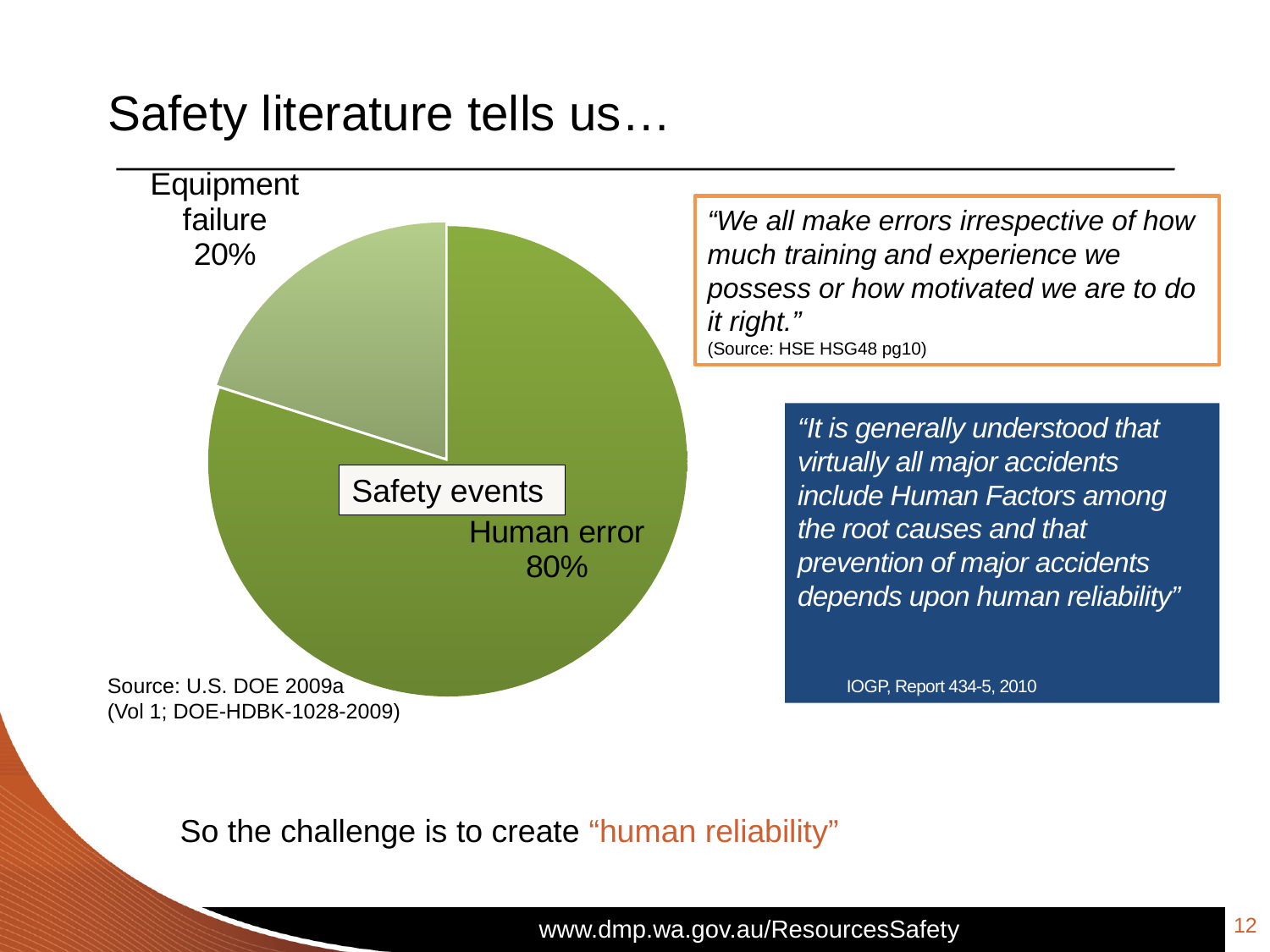
What share of safety events is attributed to Human error? 80% What is the source cited below the pie chart? U.S. DOE 2009a (Vol 1; DOE-HDBK-1028-2009) What is the title of the pie chart? Safety events What kind of chart is shown on the slide? pie chart Which slice of the pie chart is the smallest? Equipment failure Which is larger, the Human error slice or the Equipment failure slice? Human error How many slices does the pie chart have? 2 What is the difference in percentage points between the Human error and Equipment failure slices? 60 Which slice of the pie chart is the largest? Human error What share of safety events is attributed to Equipment failure? 20%